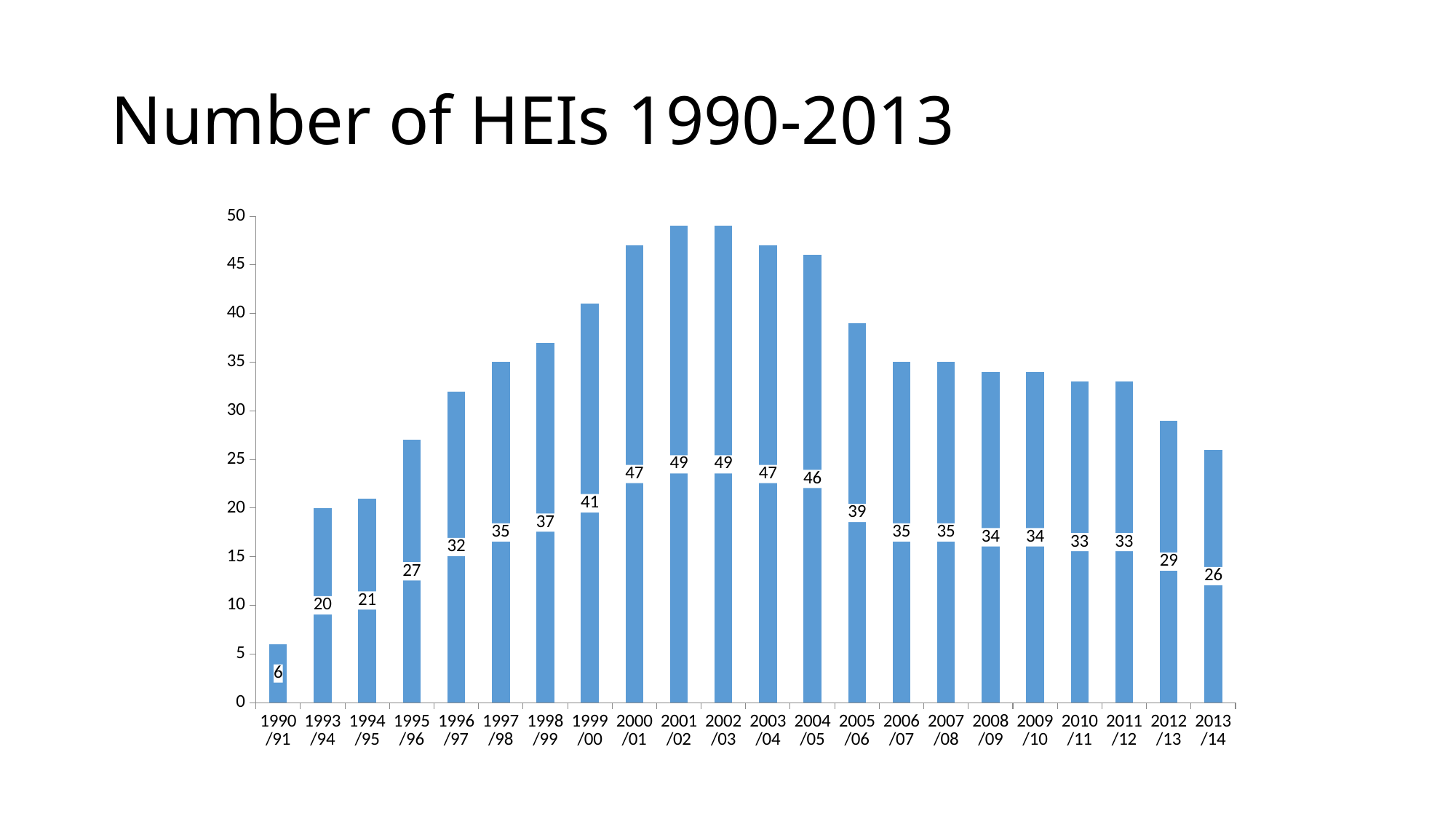
Is the number of HEIs for 2000/01 greater or less than 45? greater What is the number of HEIs for 2004/05? 46 What is the difference between the number of HEIs in 2001/02 and in 2013/14? 23 Which year has more HEIs, 2005/06 or 2012/13? 2005/06 What kind of chart is shown on the slide? Bar chart What is the number of HEIs for 1990/91? 6 Which year has the lowest number of HEIs? 1990/91 What is the number of HEIs for 2013/14? 26 What is the highest number of HEIs shown on the chart? 49 What is the difference between the number of HEIs in 1999/00 and in 1995/96? 14 How many years are shown on the x axis? 22 What is the title of the slide? Number of HEIs 1990-2013